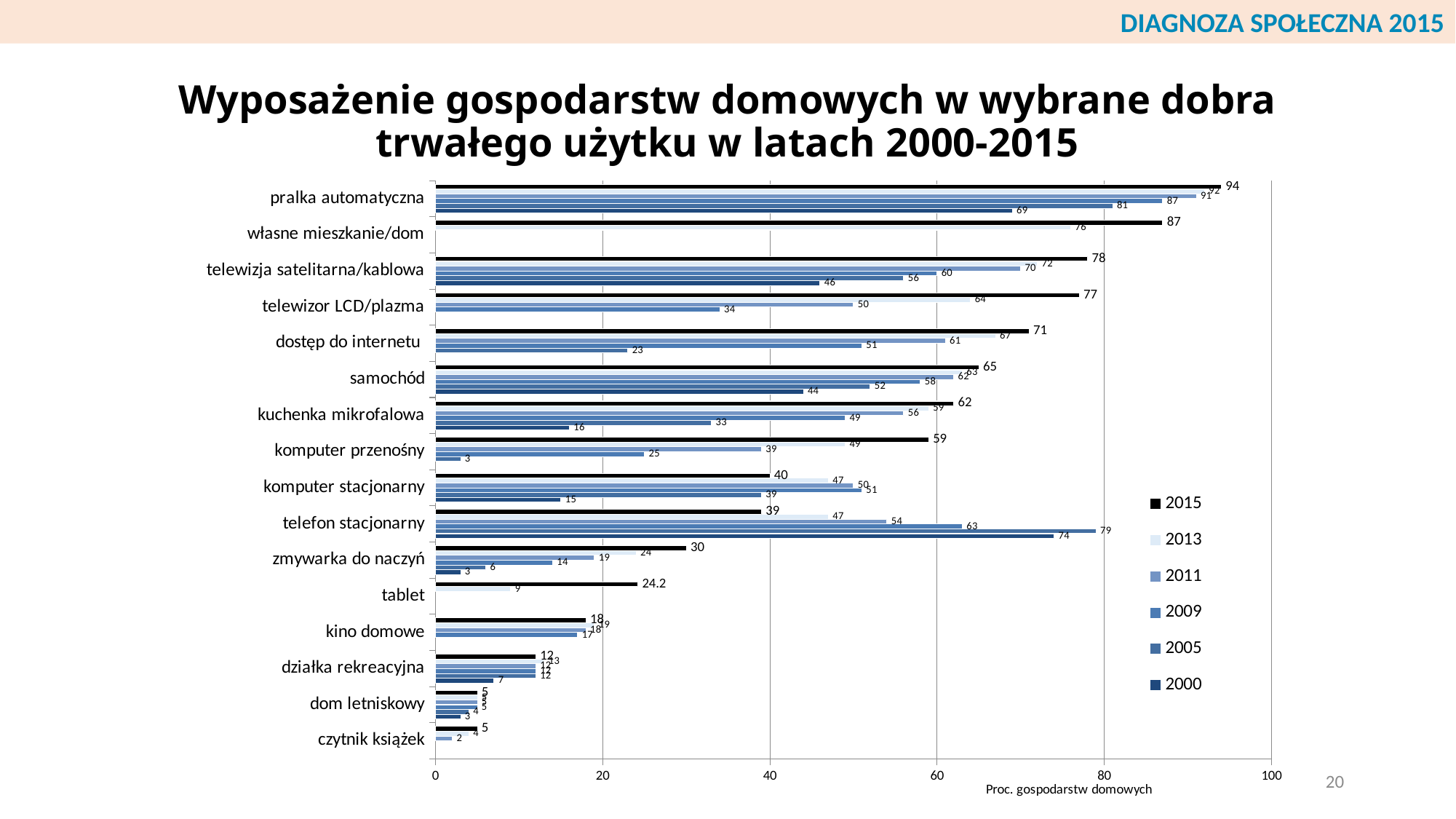
Which is larger for telefon stacjonarny: the 2005 value or the 2015 value? 2005 Which category has the highest 2015 value? pralka automatyczna What is the 2000 value for telefon stacjonarny? 74 How many categories (goods) are shown on the chart? 16 What is the 2005 value for dostęp do internetu? 23 What label is shown on the horizontal axis? Proc. gospodarstw domowych Is the 2015 value for samochód greater or less than 60? greater What is the 2015 value for pralka automatyczna? 94 How many series does the legend list? 6 What is the 2015 value for tablet? 24.2 What type of chart is shown on the slide? bar chart What is the difference between the 2015 and 2000 values for pralka automatyczna? 25